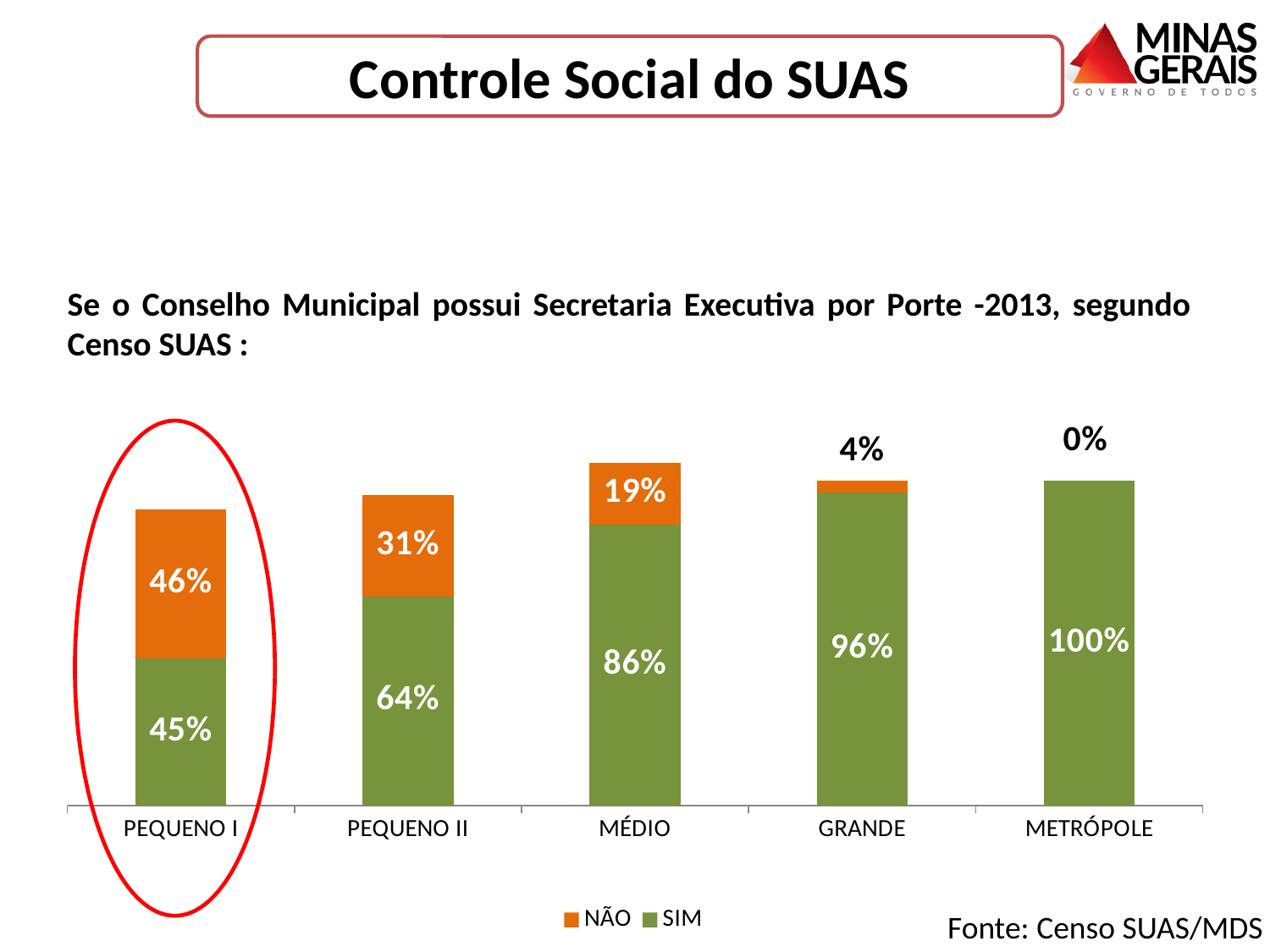
Does the SIM value rise or fall from PEQUENO I to METRÓPOLE? rise What is the SIM value for PEQUENO I? 45% Which is larger, the NÃO value for PEQUENO I or the NÃO value for MÉDIO? PEQUENO I What kind of chart is shown on the slide? stacked bar chart What is the SIM value for MÉDIO? 86% Which category has the highest SIM value? METRÓPOLE What is the NÃO value for GRANDE? 4% How many categories are shown on the x axis? 5 How many series does the legend list? 2 Which category has the lowest SIM value? PEQUENO I What is the NÃO value for PEQUENO II? 31% What is the difference between the SIM values for GRANDE and PEQUENO II? 32%